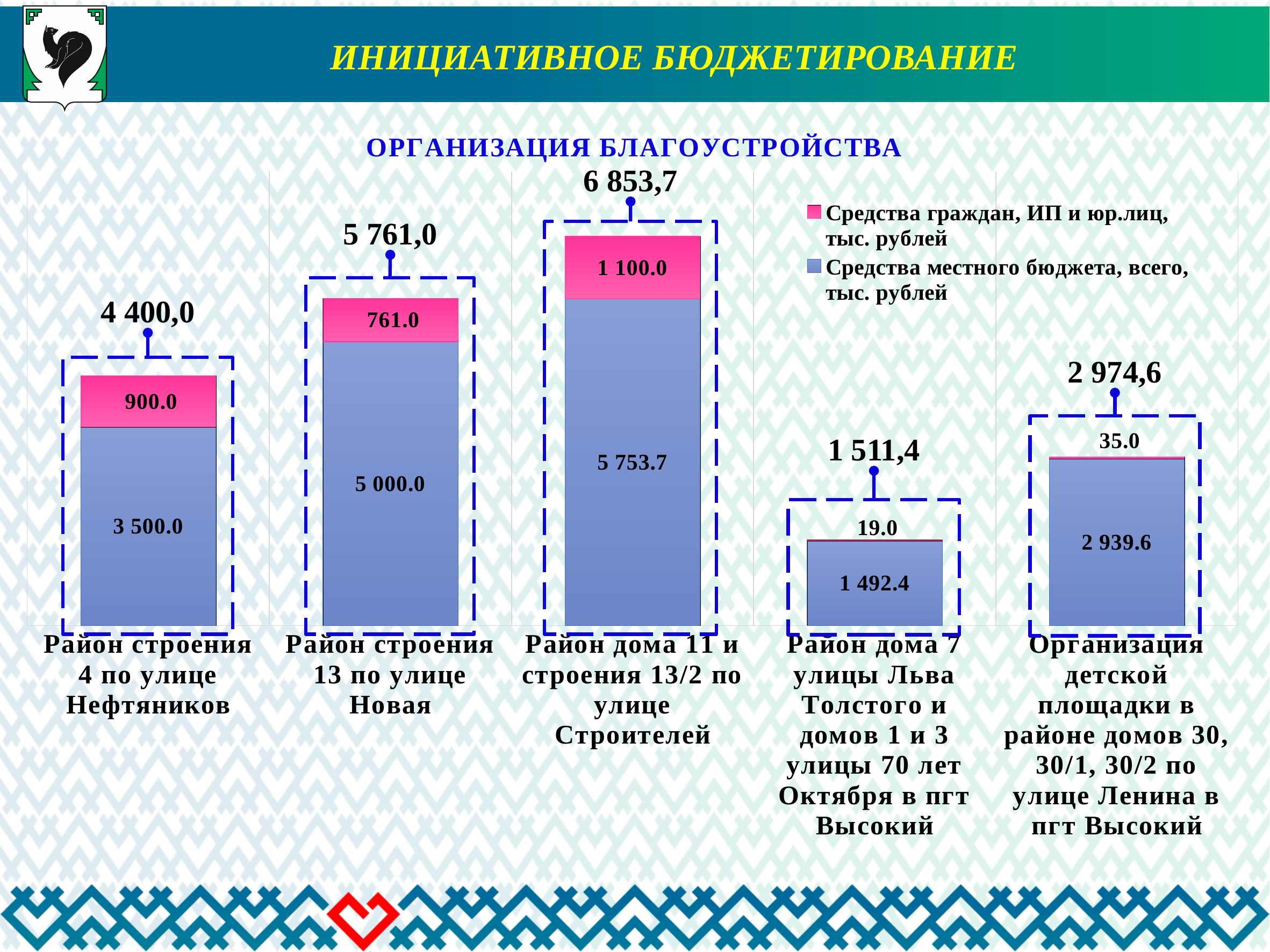
What is the total shown above the bar for "Район строения 4 по улице Нефтяников"? 4 400,0 What is the value of "Средства местного бюджета, всего, тыс. рублей" for "Район строения 13 по улице Новая"? 5 000.0 Which category has the lowest value of "Средства граждан, ИП и юр.лиц, тыс. рублей"? Район дома 7 улицы Льва Толстого и домов 1 и 3 улицы 70 лет Октября в пгт Высокий What is the difference between the "Средства граждан, ИП и юр.лиц, тыс. рублей" values for "Район строения 4 по улице Нефтяников" and "Район строения 13 по улице Новая"? 139.0 What is the value of "Средства граждан, ИП и юр.лиц, тыс. рублей" for "Район дома 11 и строения 13/2 по улице Строителей"? 1 100.0 What is the value of "Средства граждан, ИП и юр.лиц, тыс. рублей" for "Организация детской площадки в районе домов 30, 30/1, 30/2 по улице Ленина в пгт Высокий"? 35.0 How many series does the legend list? 2 What kind of chart is shown on the slide? Stacked bar chart How many categories are shown on the x axis of the chart? 5 Which is larger: the "Средства местного бюджета, всего, тыс. рублей" value for "Район строения 4 по улице Нефтяников" or for "Организация детской площадки в районе домов 30, 30/1, 30/2 по улице Ленина в пгт Высокий"? Район строения 4 по улице Нефтяников What is the value of "Средства местного бюджета, всего, тыс. рублей" for "Район дома 7 улицы Льва Толстого и домов 1 и 3 улицы 70 лет Октября в пгт Высокий"? 1 492.4 Which category has the highest total shown above its bar? Район дома 11 и строения 13/2 по улице Строителей